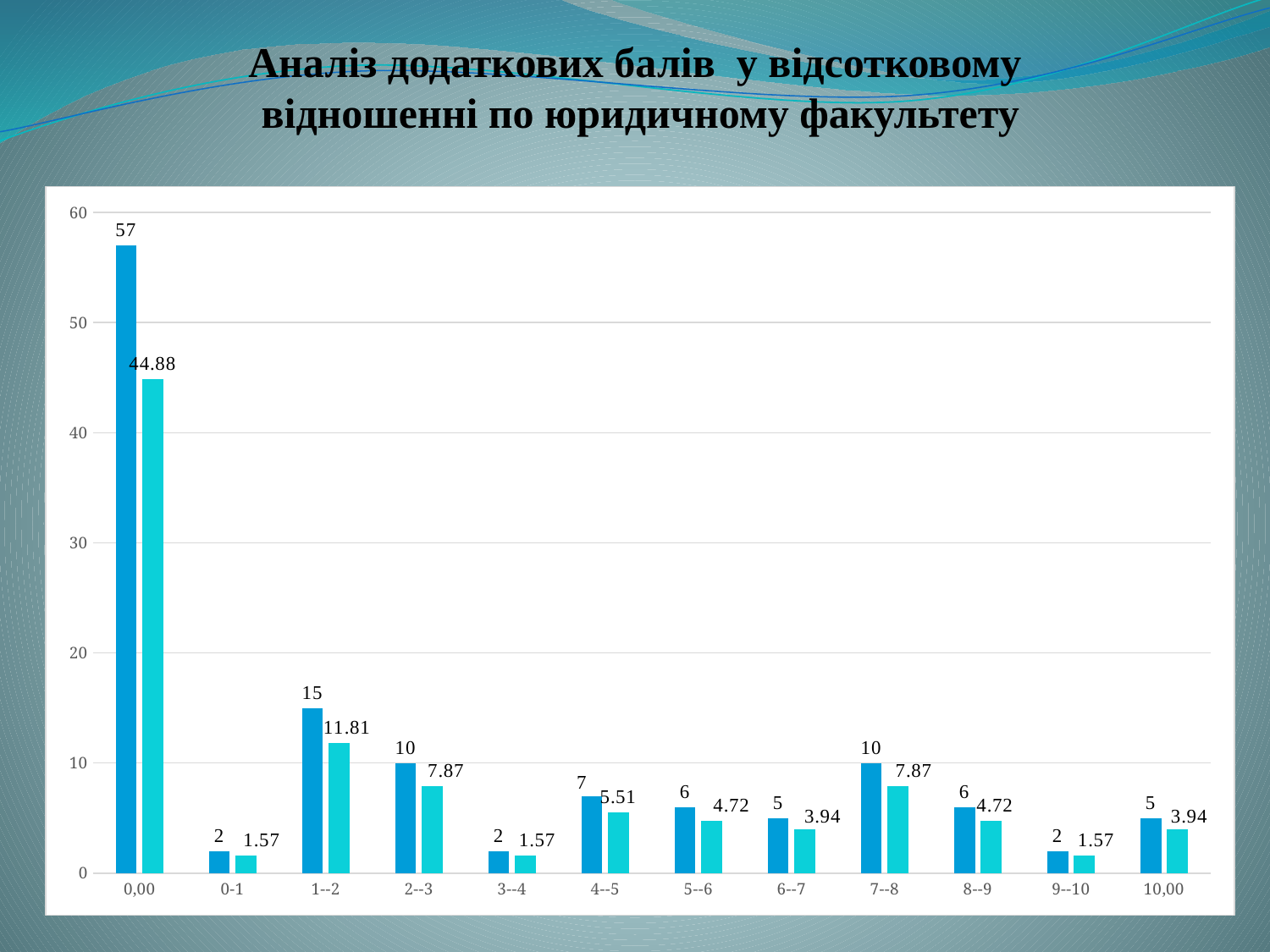
Is the dark blue bar for 0,00 greater or less than 50? greater What is the value of the dark blue bar for the category 0,00? 57 What is the value of the light blue (cyan) bar for the category 1--2? 11.81 Which category has the highest dark blue bar? 0,00 What is the title of the slide? Аналіз додаткових балів у відсотковому відношенні по юридичному факультету What is the value of the dark blue bar for the category 7--8? 10 What is the difference between the light blue (cyan) bar values for 0,00 and 1--2? 33.07 What is the difference between the dark blue bar values for 1--2 and 2--3? 5 How many categories are shown on the x axis? 12 What kind of chart is shown on the slide? bar chart Which is larger: the dark blue bar for 4--5 or the dark blue bar for 8--9? 4--5 What is the value of the light blue (cyan) bar for the category 0,00? 44.88